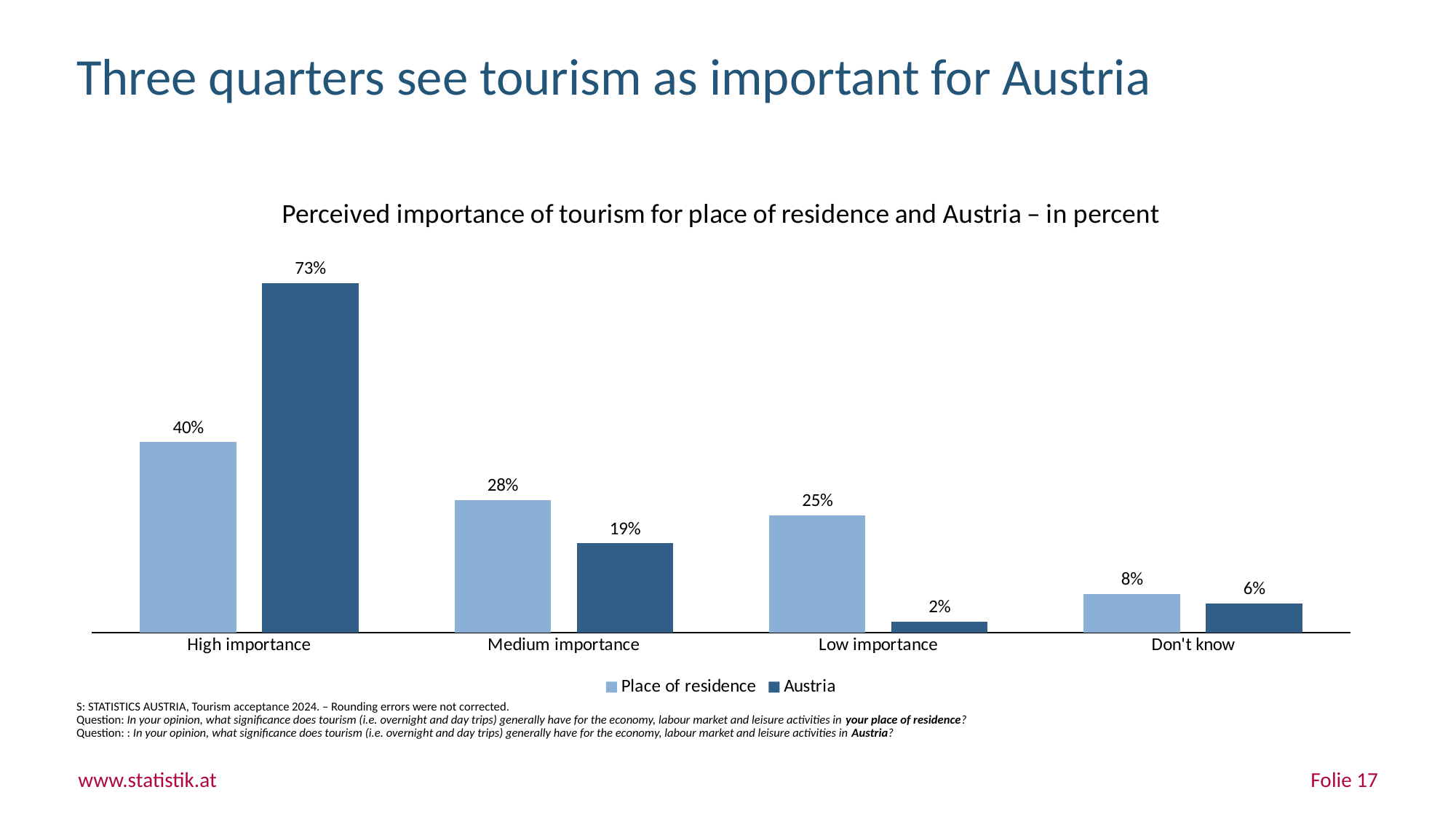
What is the difference between the Austria and Place of residence values for High importance? 33 percentage points Which category has the highest value for the Place of residence series? High importance What is the value for Place of residence in the Low importance category? 25% Which is larger for Medium importance: Place of residence or Austria? Place of residence What is the value for Austria in the High importance category? 73% Which category has the lowest value for the Austria series? Low importance What is the title of the chart? Perceived importance of tourism for place of residence and Austria – in percent How many series does the legend list? 2 Do the values for the Austria series rise or fall from High importance to Low importance? Fall How many categories are shown on the x axis? 4 What kind of chart is shown on the slide? Bar chart What is the value for Austria in the Don't know category? 6%